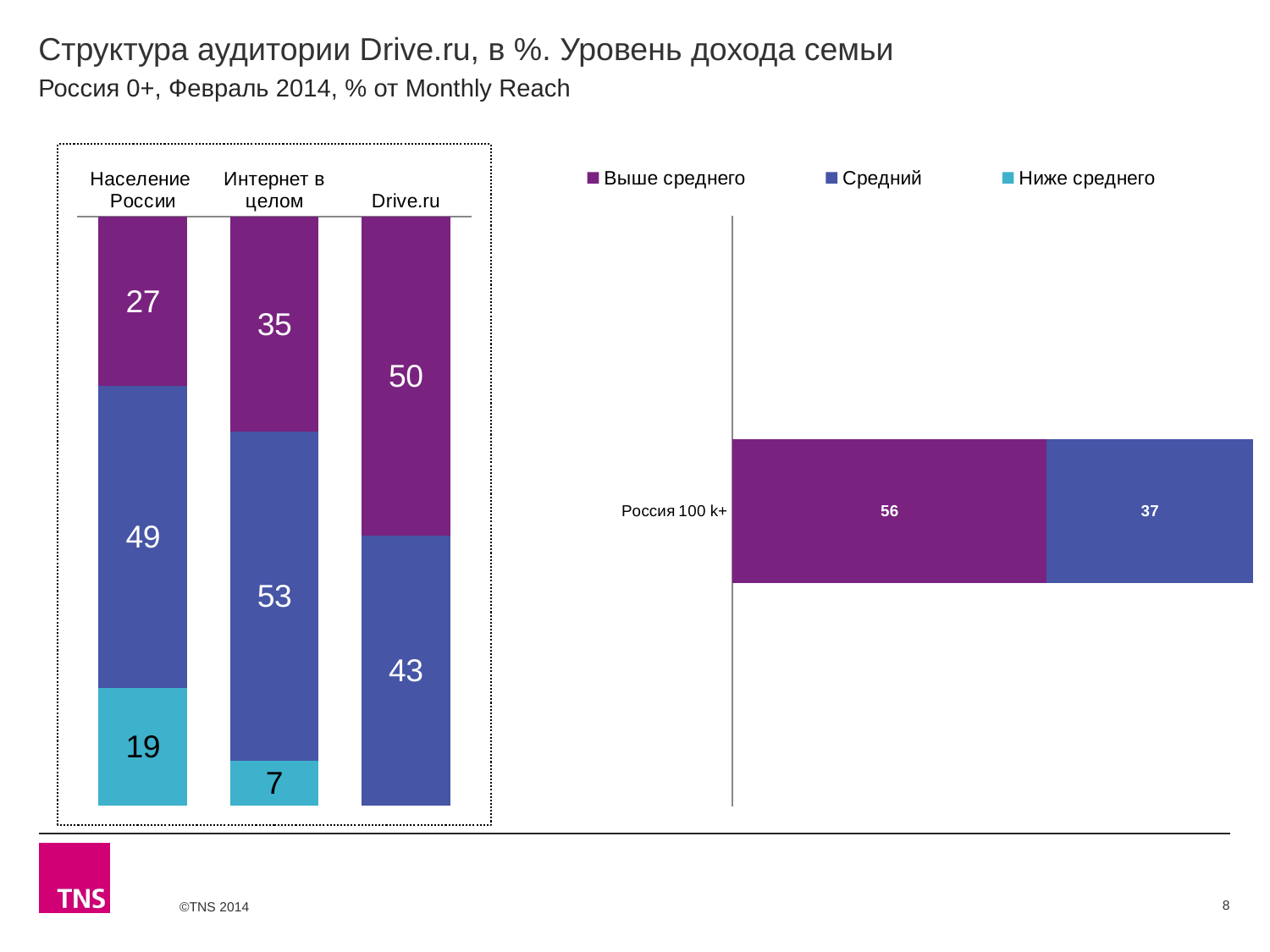
In the right chart, what is the total of the 'Выше среднего' and 'Средний' segments for 'Россия 100 k+'? 93 In the left stacked bar chart, what is the value of the 'Ниже среднего' segment for 'Население России'? 19 In the left stacked bar chart, what is the value of the 'Выше среднего' segment for Drive.ru? 50 What kind of chart is the chart on the right of the slide? Stacked bar chart How many categories are shown in the left stacked bar chart? 3 In the left stacked bar chart, what is the value of the 'Средний' segment for 'Интернет в целом'? 53 In the left stacked bar chart, what is the difference between the 'Выше среднего' values for Drive.ru and 'Население России'? 23 In the right chart, what is the value of the 'Выше среднего' segment for 'Россия 100 k+'? 56 How many series does the legend list? 3 In the left stacked bar chart, which is larger: the 'Средний' value for 'Население России' or for Drive.ru? Население России In the left stacked bar chart, which category has the highest 'Выше среднего' value? Drive.ru